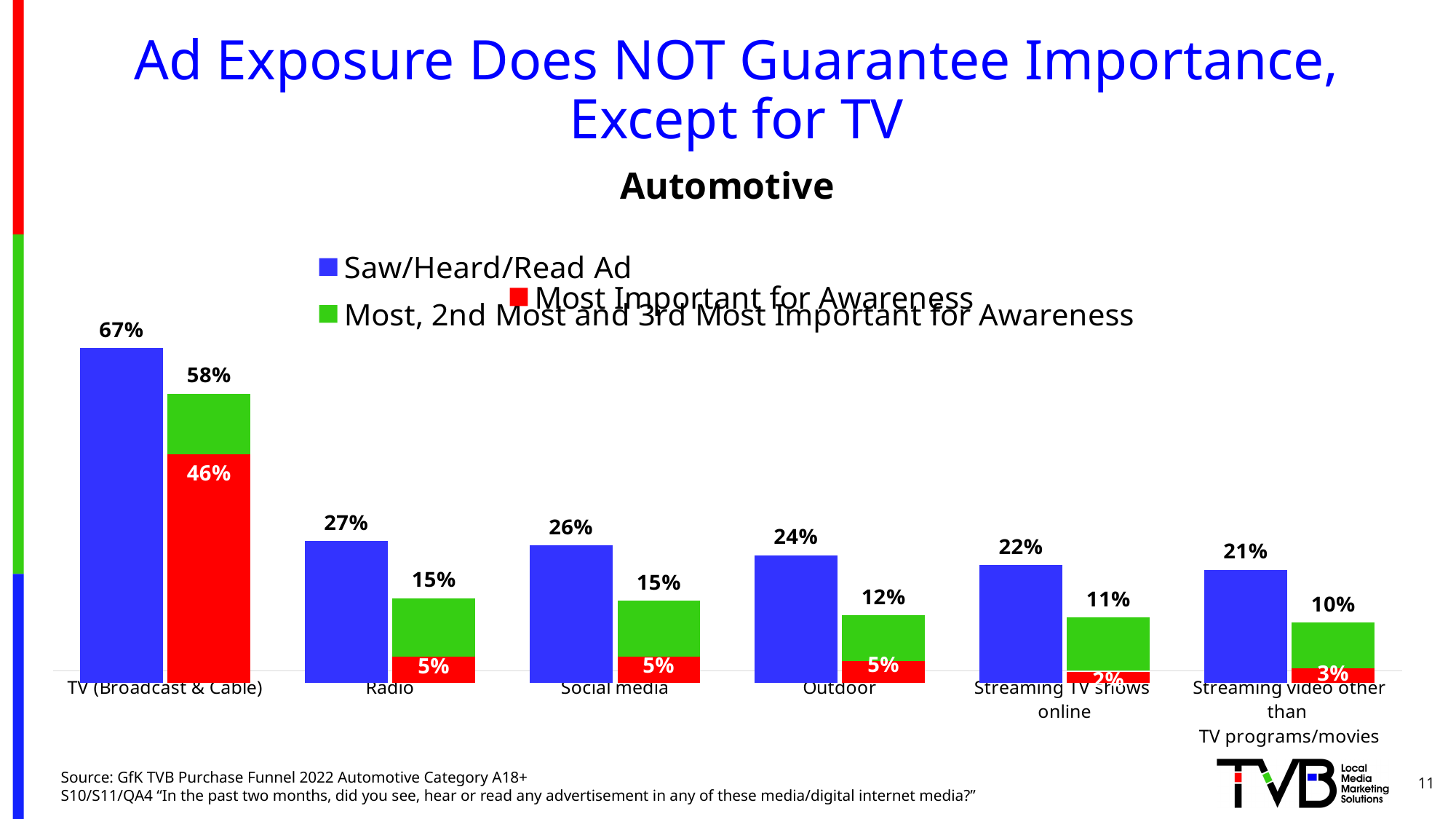
What type of chart is shown on the slide? Bar chart What is the difference between the Saw/Heard/Read Ad values for TV (Broadcast & Cable) and Radio? 40 percentage points What is the Most, 2nd Most and 3rd Most Important for Awareness value for Streaming video other than TV programs/movies? 10% Which is larger: the Saw/Heard/Read Ad value for Social media or for Streaming TV shows online? Social media What percentage of respondents Saw/Heard/Read Ad for TV (Broadcast & Cable)? 67% Which medium has the lowest Most Important for Awareness value? Streaming TV shows online How many series does the legend list? 3 What is the Most Important for Awareness value for TV (Broadcast & Cable)? 46% What is the Saw/Heard/Read Ad value for Outdoor? 24% How many media categories are shown on the x axis? 6 Which medium has the highest Saw/Heard/Read Ad value? TV (Broadcast & Cable) Which colour represents the Saw/Heard/Read Ad series? Blue